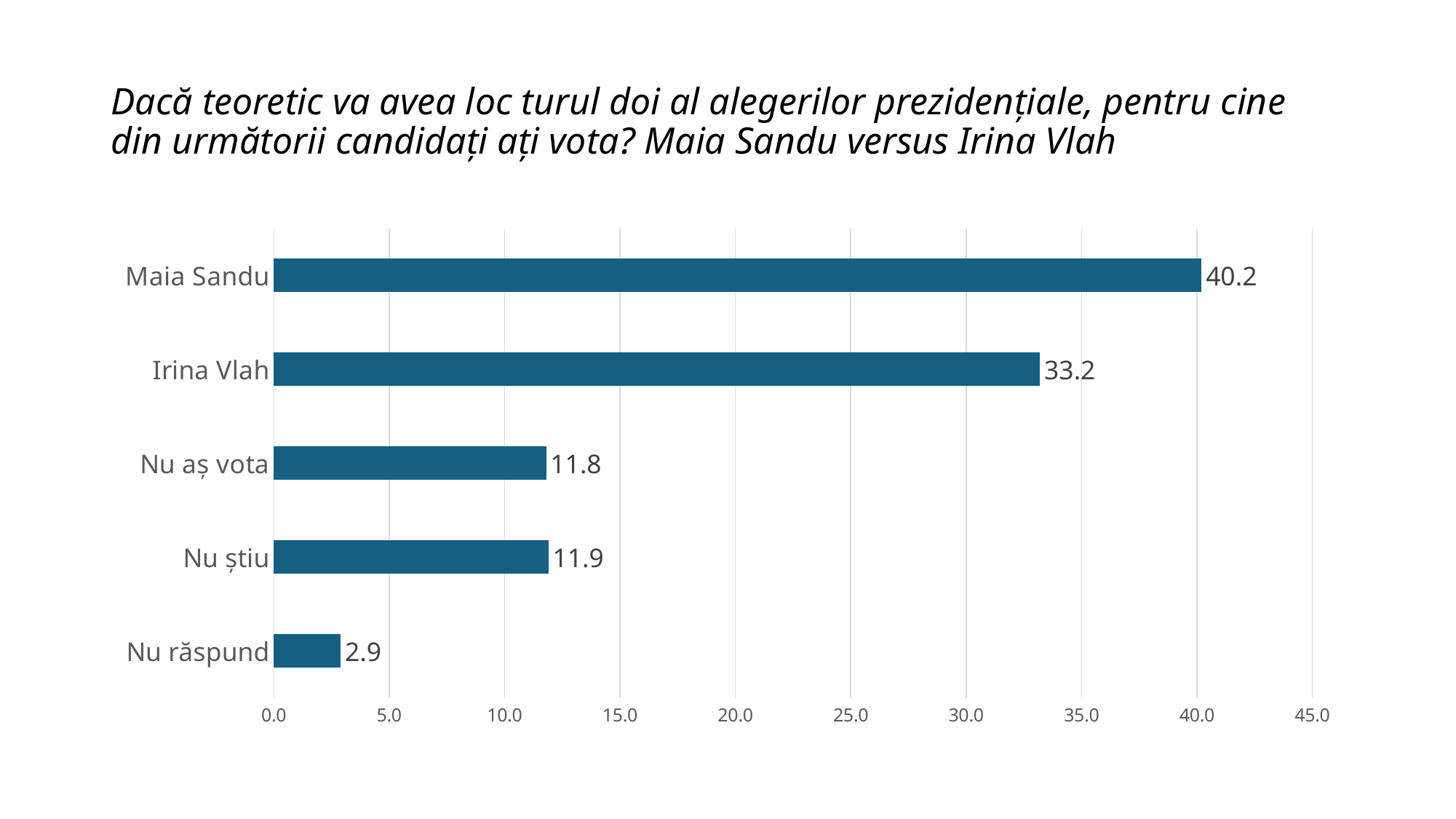
What is the value for Maia Sandu? 40.2 Which is larger, the value for Irina Vlah or the value for Nu știu? Irina Vlah What is the highest value shown on the x axis? 45.0 What is the value for Irina Vlah? 33.2 Is the value for Irina Vlah greater or less than 30.0? greater Which category has the lowest value? Nu răspund What is the difference between the values for Maia Sandu and Irina Vlah? 7.0 Which category has the highest value? Maia Sandu What kind of chart is shown on the slide? bar chart What is the value for Nu răspund? 2.9 What is the value for Nu aș vota? 11.8 How many categories are shown in the chart? 5